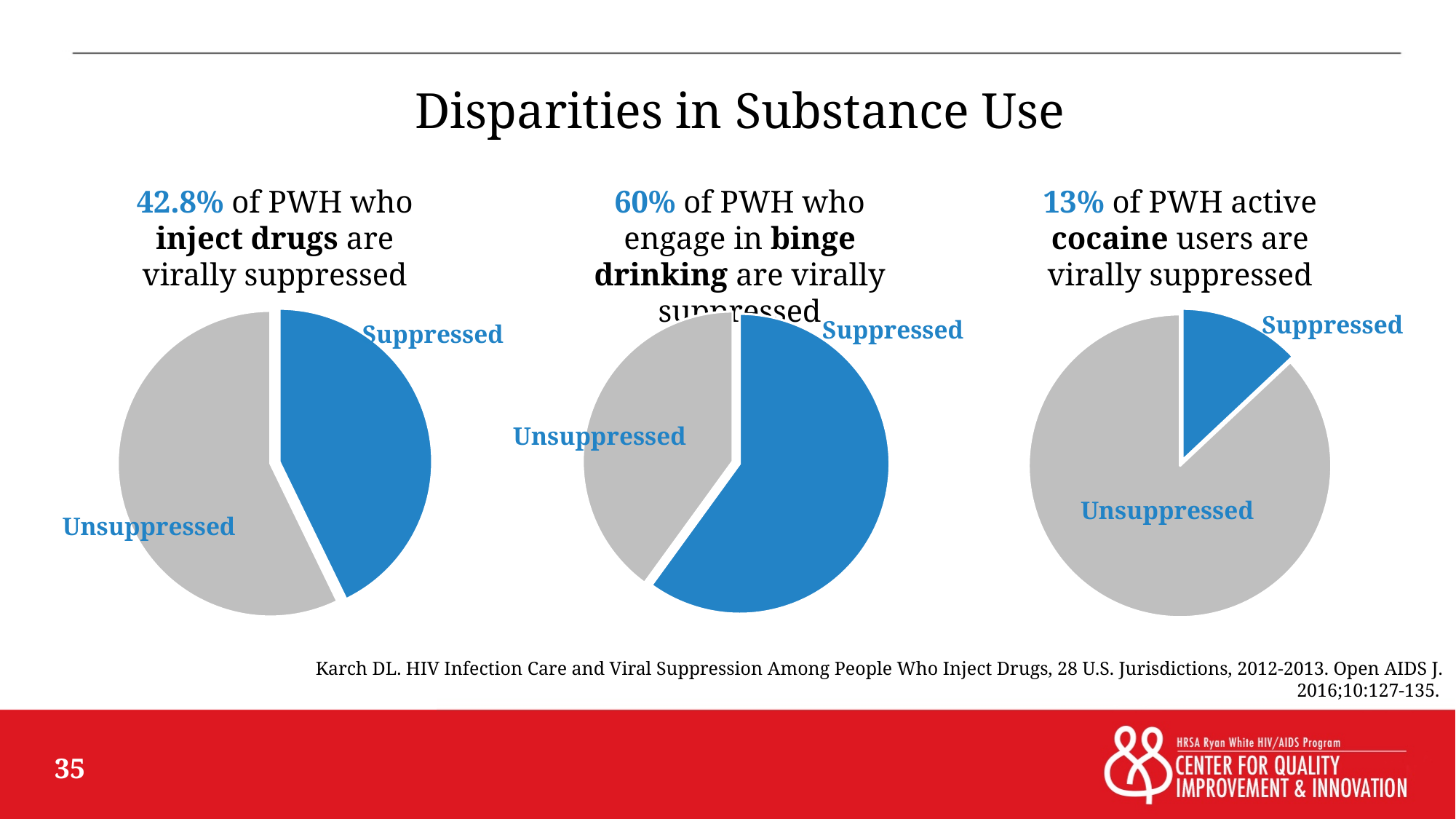
What is the title of the slide containing the three pie charts? Disparities in Substance Use In the middle pie chart (PWH who engage in binge drinking), what share are virally suppressed? 60% How many pie charts are shown on the slide? 3 In the left pie chart (PWH who inject drugs), what share are virally suppressed? 42.8% What kind of chart is used for the 'inject drugs' group on the left of the slide? pie chart Across the three pie charts, which group has the lowest share virally suppressed? cocaine users What colour is the Suppressed slice in each pie chart? blue In the middle pie chart (binge drinking), which slice is larger, Suppressed or Unsuppressed? Suppressed Across the three pie charts, which group has the highest share virally suppressed? binge drinking In the right pie chart (cocaine users), which slice is larger, Suppressed or Unsuppressed? Unsuppressed How many slices does each pie chart on the slide have? 2 In the right pie chart (PWH active cocaine users), what share are virally suppressed? 13%